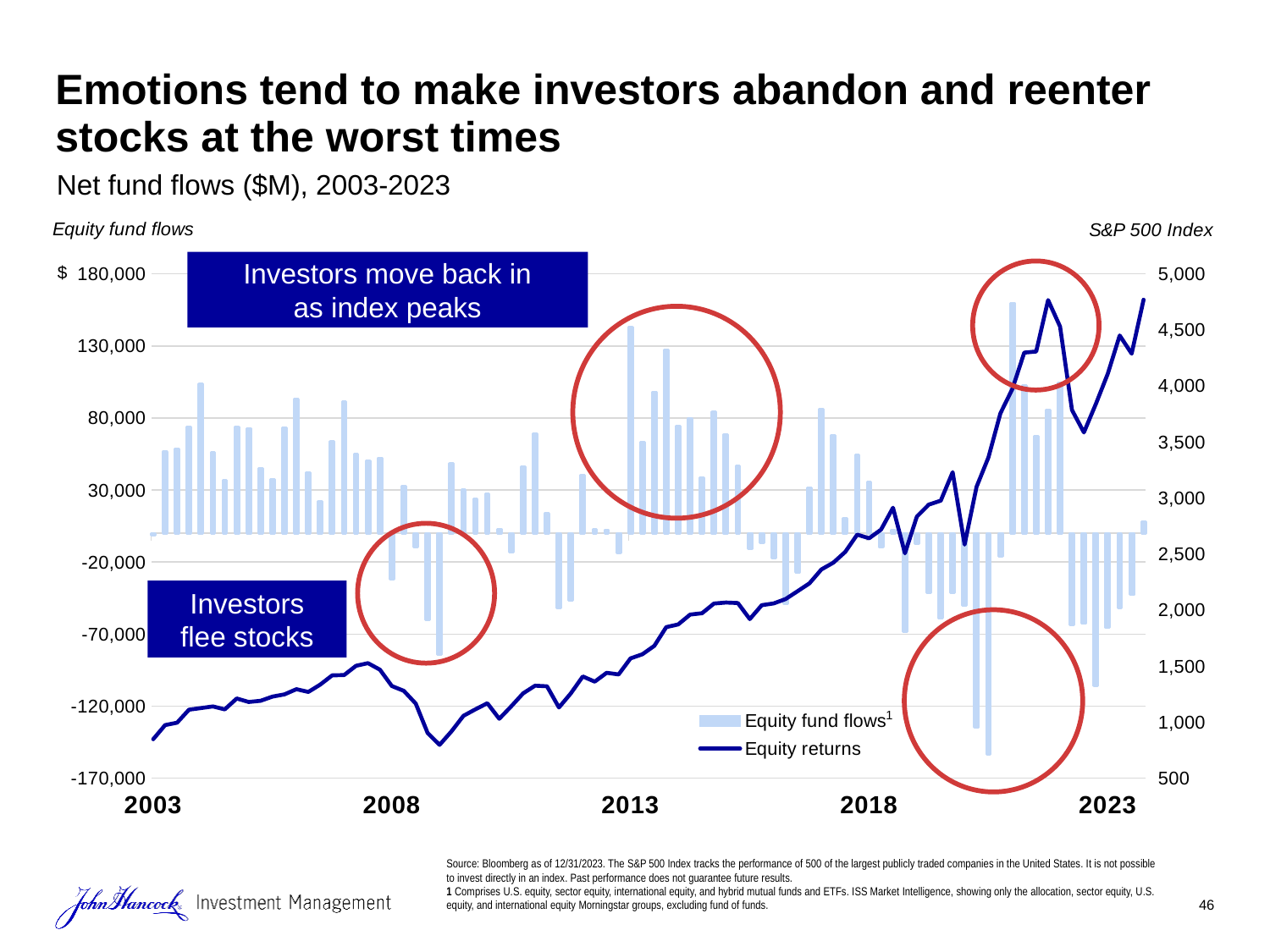
What kind of chart is shown on the slide? A combination bar and line chart Does the Equity returns line generally rise or fall from 2003 to 2023? rise What are the two series named in the chart's legend? Equity fund flows and Equity returns Is the S&P 500 Index value at the end of 2023 greater or less than 4,500? greater Is the lowest equity fund flow bar, around 2021, greater or less than -120,000? less Is the tallest equity fund flow bar, around 2021, greater or less than 130,000? greater What is the label of the right-hand vertical axis of the chart? S&P 500 Index Which is higher on the S&P 500 Index line: the value at the end of 2023 or the value at the start of 2003? The value at the end of 2023 What is the highest tick value shown on the left-hand vertical axis of the chart? $ 180,000 How many series does the chart's legend list? 2